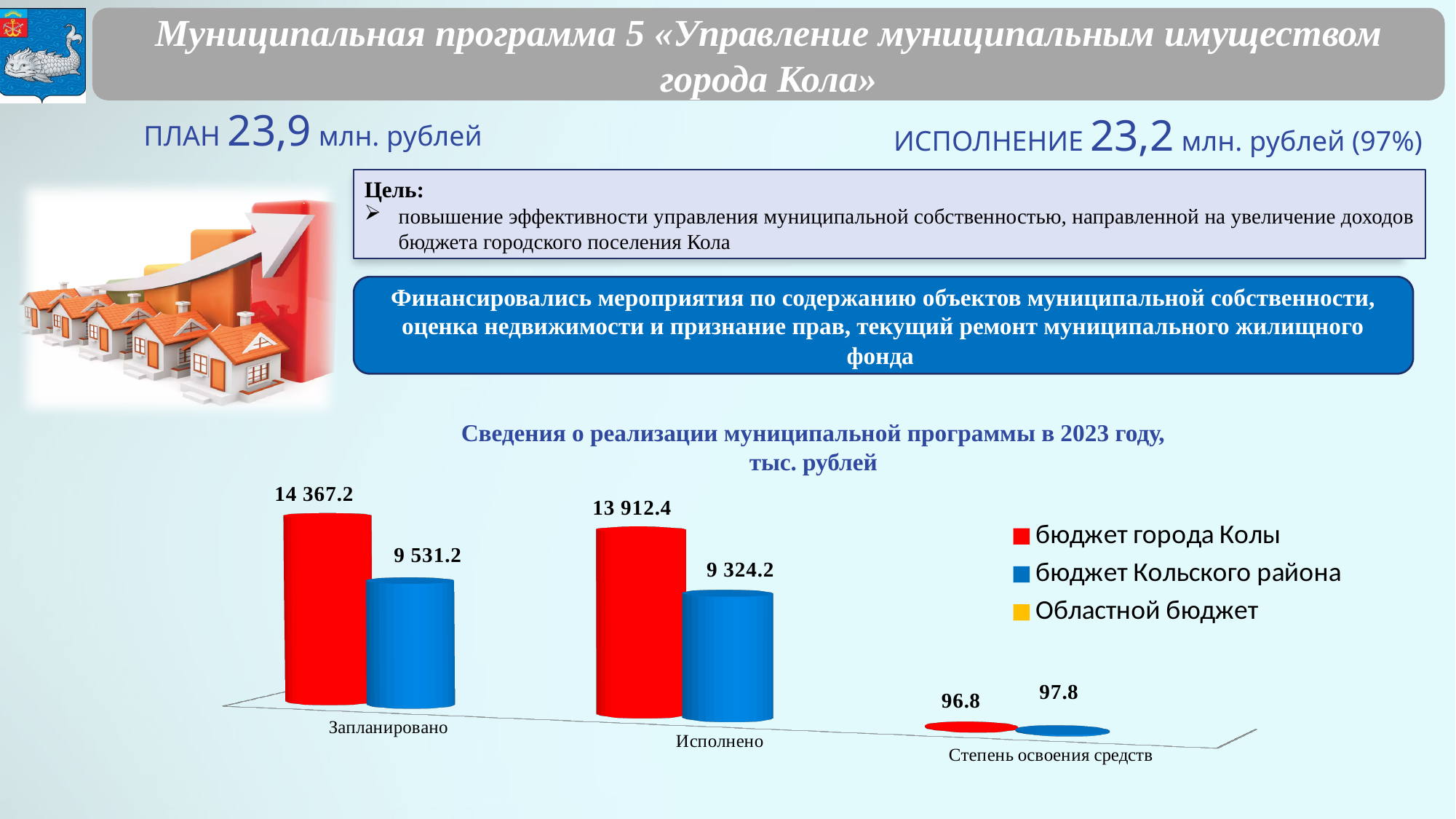
Which is larger: the Степень освоения средств value for бюджет города Колы or for бюджет Кольского района? бюджет Кольского района What kind of chart is shown on the slide? bar chart What is the value for бюджет Кольского района in the Исполнено category? 9 324.2 What is the difference between the Запланировано and Исполнено values for бюджет города Колы? 454.8 What is the difference between the бюджет города Колы and бюджет Кольского района values in the Запланировано category? 4 836.0 What is the value for бюджет города Колы in the Исполнено category? 13 912.4 What is the value for бюджет города Колы in the Запланировано category? 14 367.2 What is the title of the chart? Сведения о реализации муниципальной программы в 2023 году, тыс. рублей Which series has the highest value in the Запланировано category? бюджет города Колы What is the value for бюджет Кольского района in the Степень освоения средств category? 97.8 How many categories are shown on the x axis of the chart? 3 How many series does the chart legend list? 3